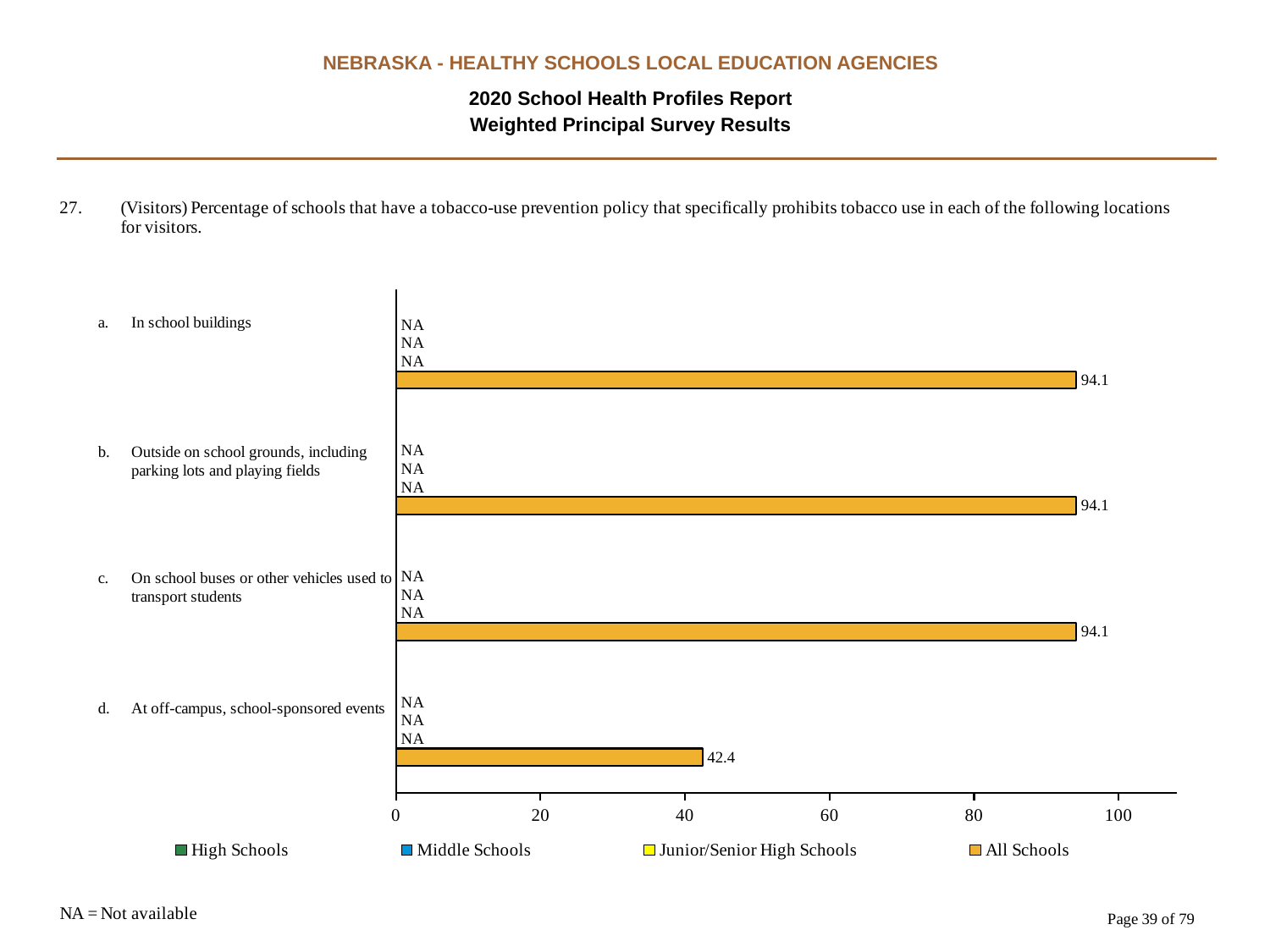
What is the All Schools value for 'On school buses or other vehicles used to transport students'? 94.1 How many locations (categories) are shown in the chart? 4 Is the All Schools value for 'At off-campus, school-sponsored events' greater or less than 60? less What value is shown for High Schools for 'In school buildings'? NA What kind of chart is shown on the slide? bar chart What is the All Schools value for 'In school buildings'? 94.1 What is the All Schools value for 'At off-campus, school-sponsored events'? 42.4 How many series does the legend list? 4 Which is larger: the All Schools value for 'Outside on school grounds, including parking lots and playing fields' or for 'At off-campus, school-sponsored events'? Outside on school grounds, including parking lots and playing fields What is the difference between the All Schools values for 'In school buildings' and 'At off-campus, school-sponsored events'? 51.7 What does NA stand for according to the slide? Not available Which location has the lowest All Schools value? At off-campus, school-sponsored events